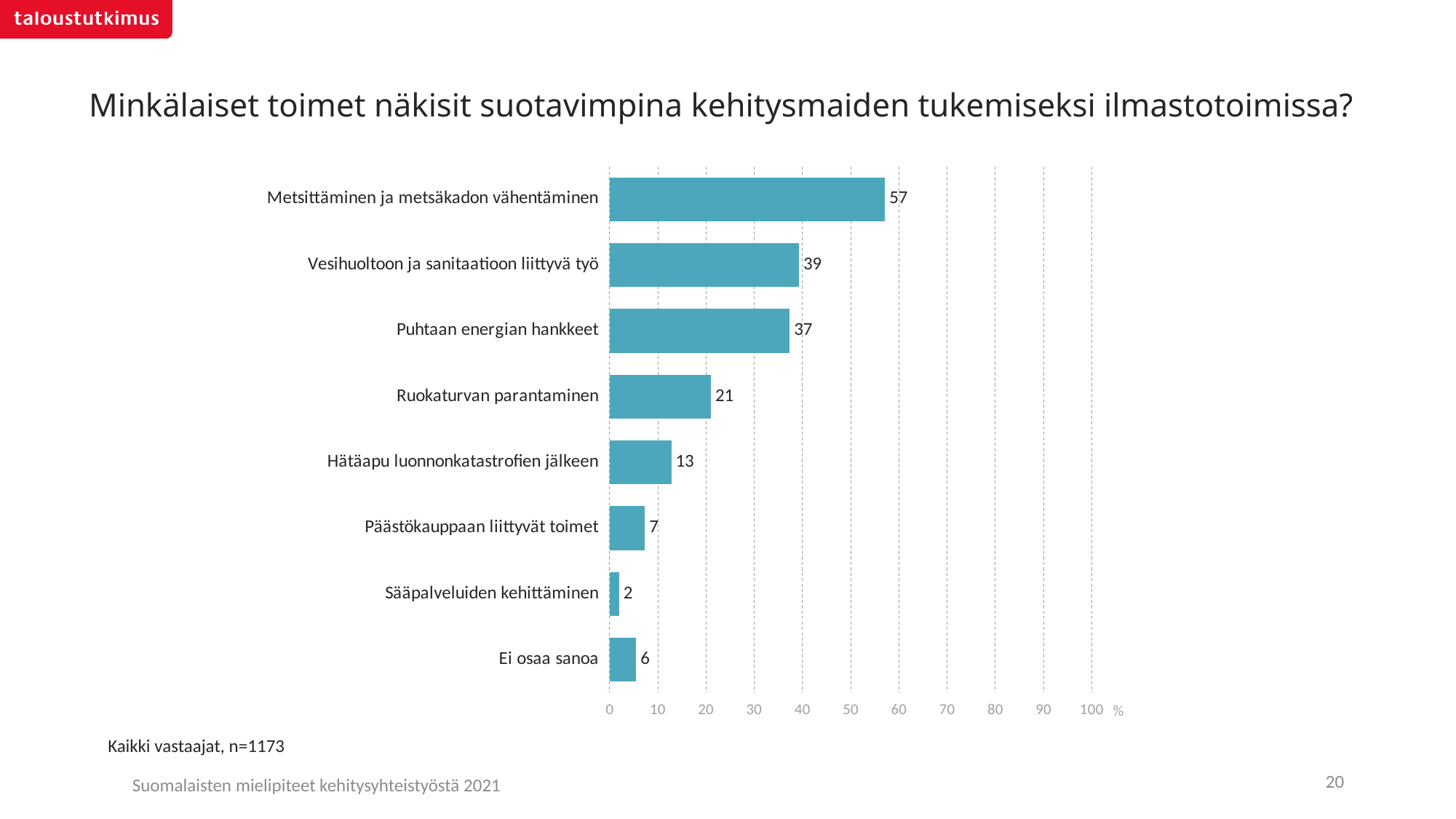
What is the maximum value shown on the horizontal axis? 100 What is the value for "Hätäapu luonnonkatastrofien jälkeen"? 13 What is the value for "Metsittäminen ja metsäkadon vähentäminen"? 57 How many categories are shown in the chart? 8 What is the value for "Puhtaan energian hankkeet"? 37 Which category has the highest value? Metsittäminen ja metsäkadon vähentäminen What is the value for "Ei osaa sanoa"? 6 What is the difference between the values for "Vesihuoltoon ja sanitaatioon liittyvä työ" and "Ruokaturvan parantaminen"? 18 Which category has the lowest value? Sääpalveluiden kehittäminen Which is larger: the value for "Päästökauppaan liittyvät toimet" or the value for "Ei osaa sanoa"? Päästökauppaan liittyvät toimet What kind of chart is shown on the slide? Bar chart Is the value for "Vesihuoltoon ja sanitaatioon liittyvä työ" greater or less than 30? greater